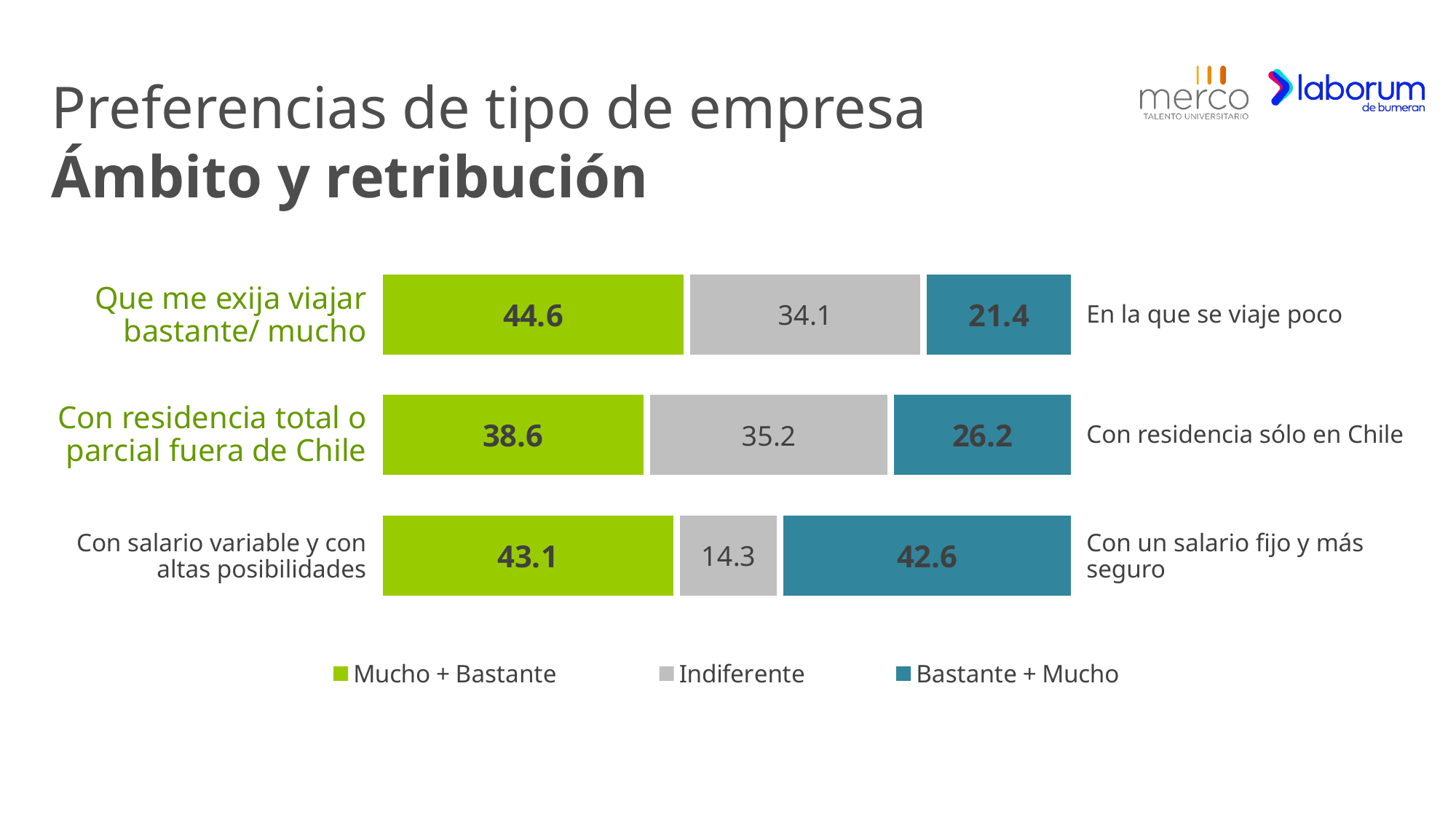
What kind of chart is shown on the slide? Stacked horizontal bar chart What colour represents the 'Indiferente' series in the legend? Grey What is the 'Indiferente' value for the 'Con residencia total o parcial fuera de Chile' row? 35.2 Which row has the lowest 'Indiferente' value? Con salario variable y con altas posibilidades How many rows (bars) does the chart show? 3 What is the 'Mucho + Bastante' value for 'Que me exija viajar bastante/ mucho'? 44.6 How many series does the legend list? 3 What is the 'Bastante + Mucho' value for 'Con un salario fijo y más seguro'? 42.6 Which row has the highest 'Bastante + Mucho' value? Con un salario fijo y más seguro What is the difference between the 'Mucho + Bastante' value (44.6) and the 'Bastante + Mucho' value (21.4) in the first row? 23.2 What is the 'Bastante + Mucho' value for 'En la que se viaje poco'? 21.4 Which is larger in the second row: 'Mucho + Bastante' (38.6) or 'Bastante + Mucho' (26.2)? Mucho + Bastante